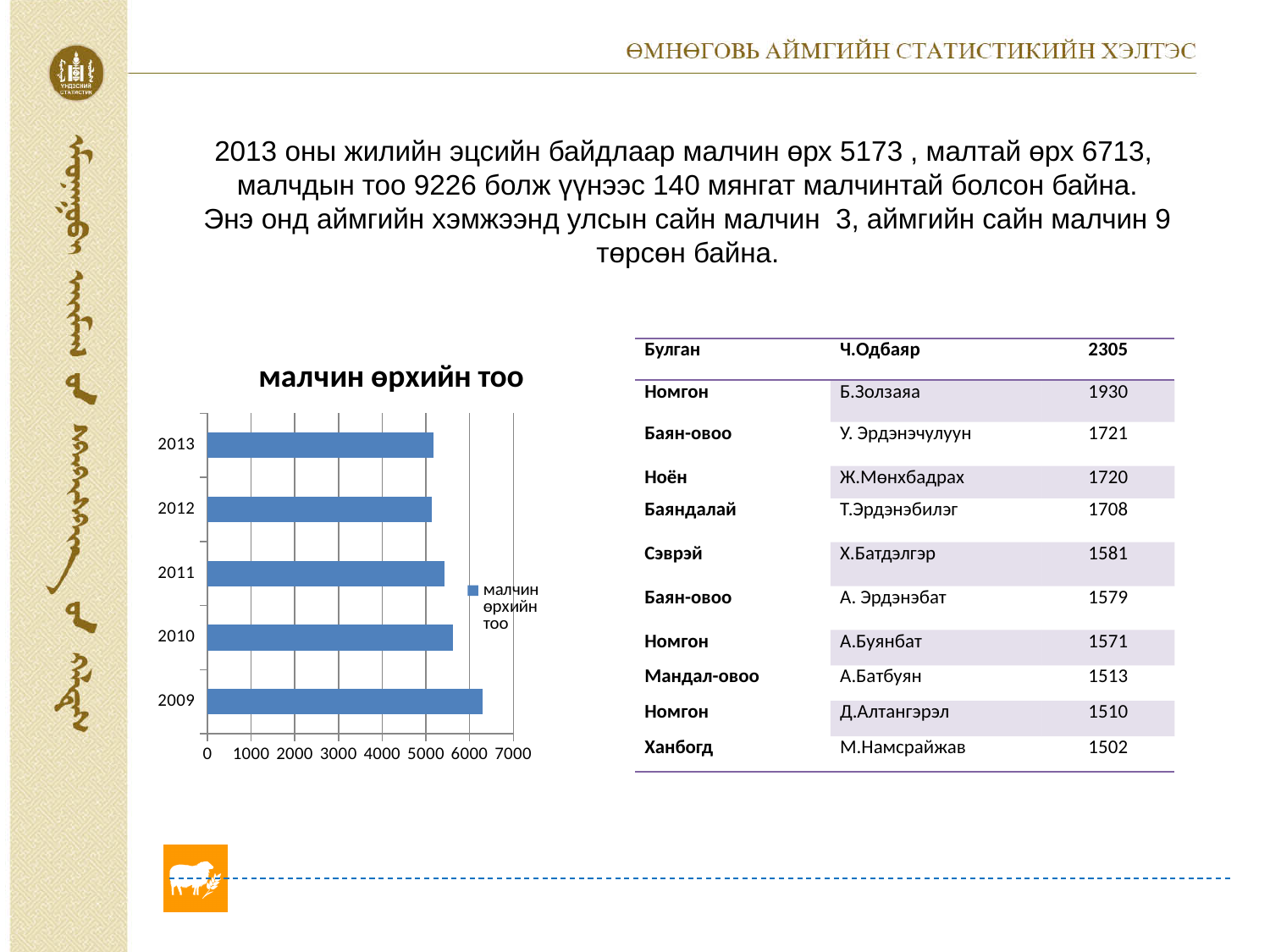
Is the value for 2013 greater or less than 5000? greater Is the value for 2010 greater or less than 6000? less What kind of chart is shown on the slide? bar chart Which year has the highest value in the chart? 2009 Is the value for 2009 greater or less than 6000? greater Do the values generally rise or fall from 2009 to 2013? fall What is the title of the chart? малчин өрхийн тоо How many series does the chart legend list? 1 Which is larger, the value for 2009 or the value for 2010? 2009 How many years (categories) are plotted in the chart? 5 Which is larger, the value for 2009 or the value for 2013? 2009